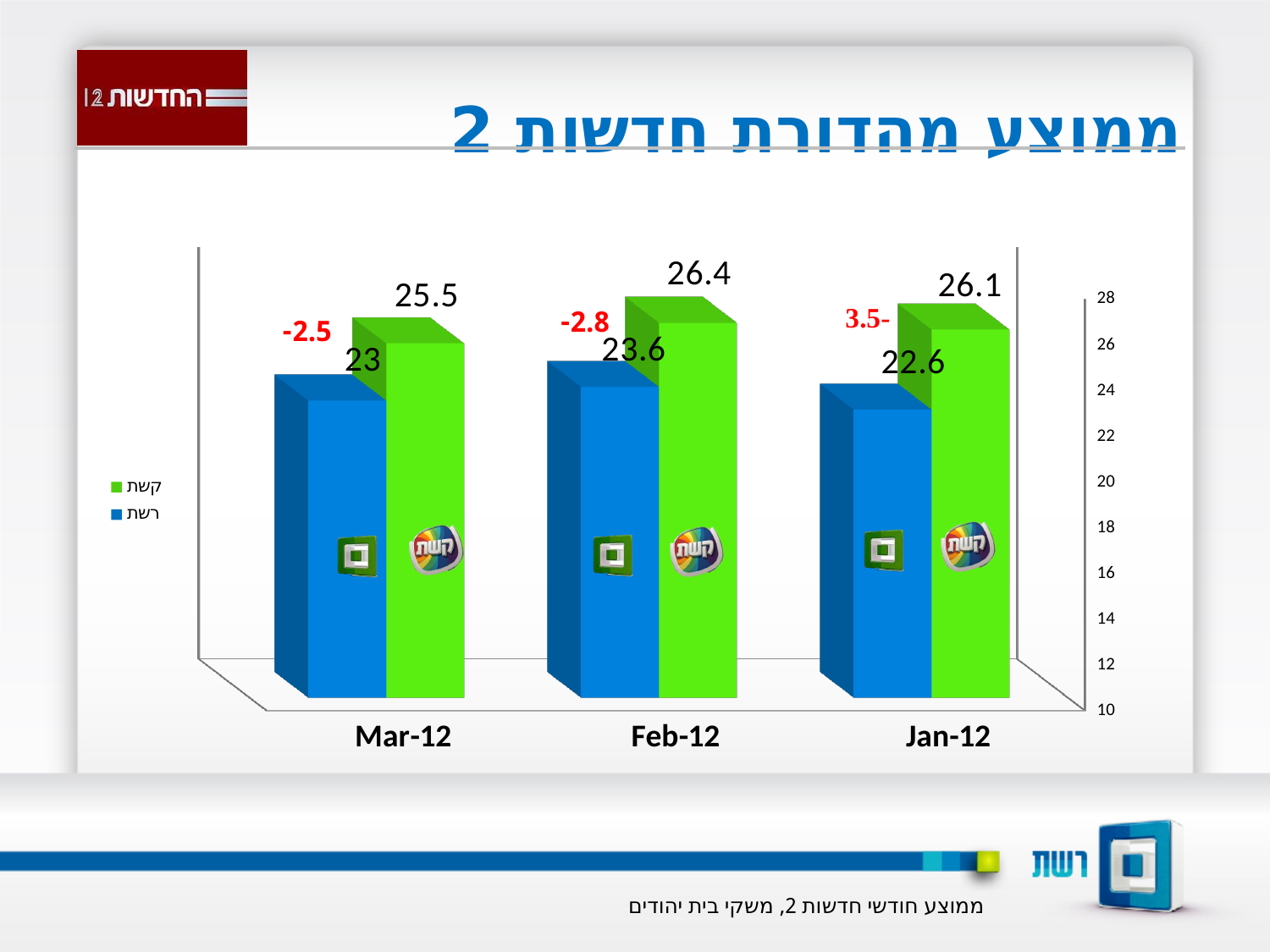
What is the difference between the קשת and רשת values in Mar-12? 2.5 In which month is the רשת value lowest? Jan-12 How many series does the legend list? 2 In which month is the קשת value highest? Feb-12 How many months are shown on the x axis? 3 What kind of chart is shown on the slide? Bar chart What is the value for רשת in Jan-12? 22.6 What is the value for קשת in Feb-12? 26.4 What is the value for קשת in Jan-12? 26.1 Which colour represents קשת in the chart? Green What is the value for רשת in Mar-12? 23 Which is larger in Feb-12, the קשת value or the רשת value? קשת